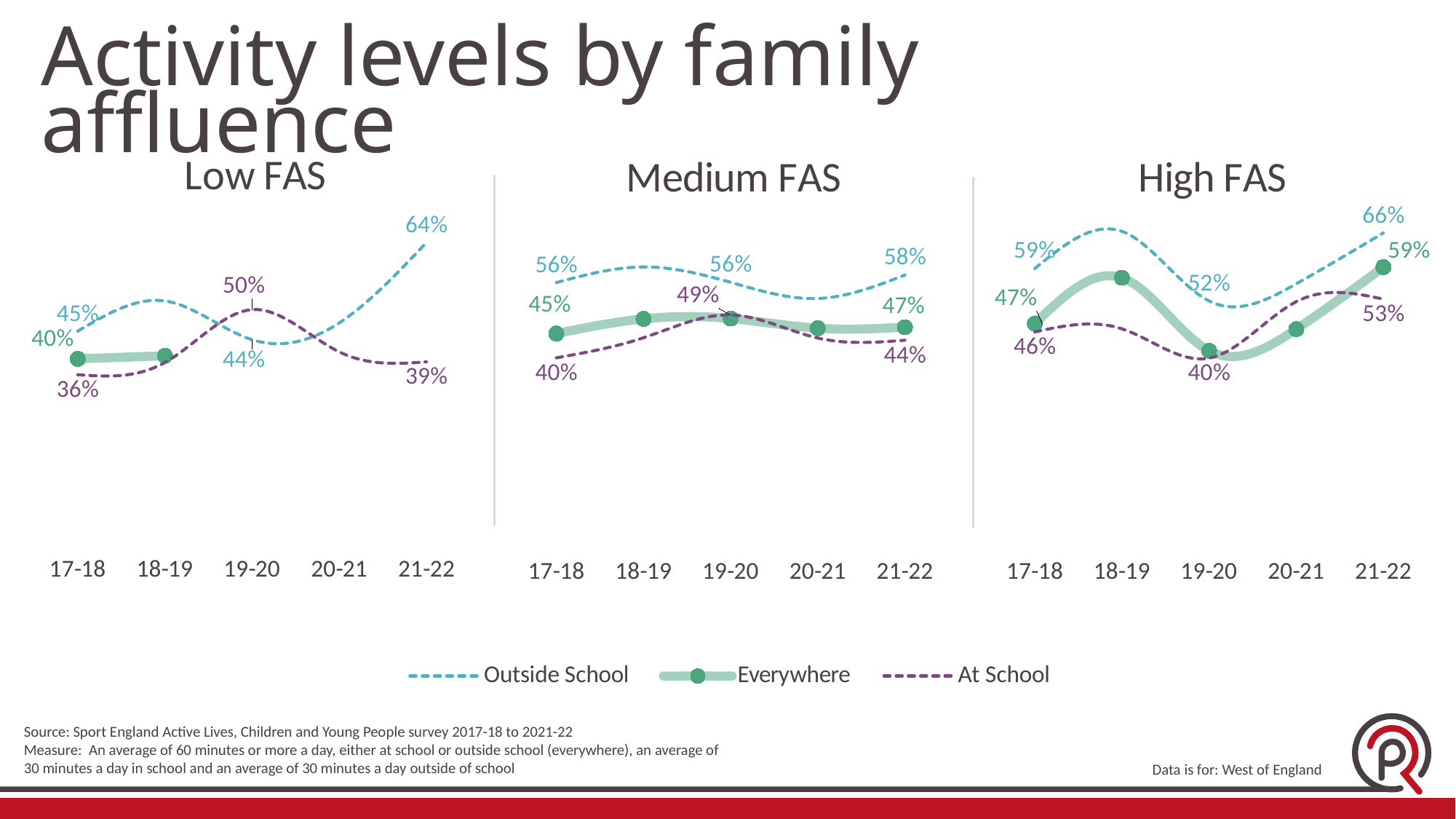
In the Low FAS chart, what is the difference between the Outside School values for 21-22 and 17-18? 19% In the High FAS chart, does the Everywhere series rise or fall from 19-20 to 21-22? Rise In the High FAS chart, what is the At School value for 19-20? 40% In the Low FAS chart, what is the At School value for 19-20? 50% In the Low FAS chart, what is the Outside School value for 21-22? 64% In the High FAS chart, what is the Outside School value for 21-22? 66% What kind of chart is the High FAS chart? Line chart In the High FAS chart, what is the difference between the Everywhere values for 21-22 and 17-18? 12% In the Medium FAS chart, what is the Everywhere value for 21-22? 47% How many time periods are shown on the x axis of the Medium FAS chart? 5 How many series does the legend list? 3 In the Medium FAS chart, which is larger for 21-22: Outside School or At School? Outside School